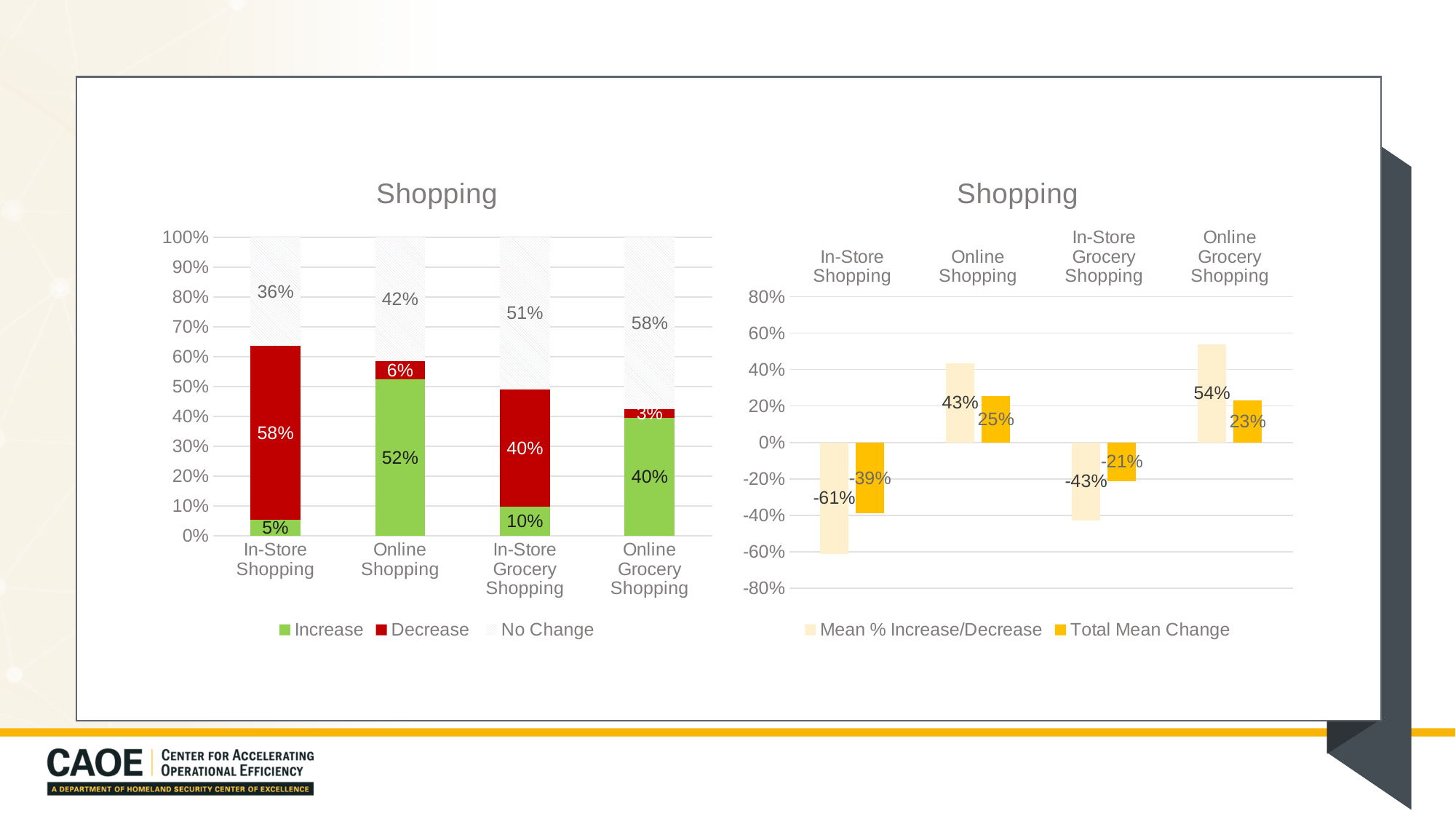
On the left chart, what is the difference between the Decrease values for In-Store Shopping and In-Store Grocery Shopping? 18% On the right chart, what is the Total Mean Change value for Online Grocery Shopping? 23% On the left chart, what is the Decrease value for In-Store Shopping? 58% On the left chart, which category has the highest Increase value? Online Shopping On the left chart, what is the Increase value for Online Shopping? 52% On the right chart, what is the Mean % Increase/Decrease value for In-Store Shopping? -61% On the left chart, what is the No Change value for In-Store Grocery Shopping? 51% On the right chart, which category has the highest Mean % Increase/Decrease value? Online Grocery Shopping On the left chart, which category has the lowest Decrease value? Online Grocery Shopping What kind of chart is the right chart? Bar chart On the left chart, how many series does the legend list? 3 On the right chart, is the Total Mean Change for Online Shopping larger than the Total Mean Change for Online Grocery Shopping? Yes